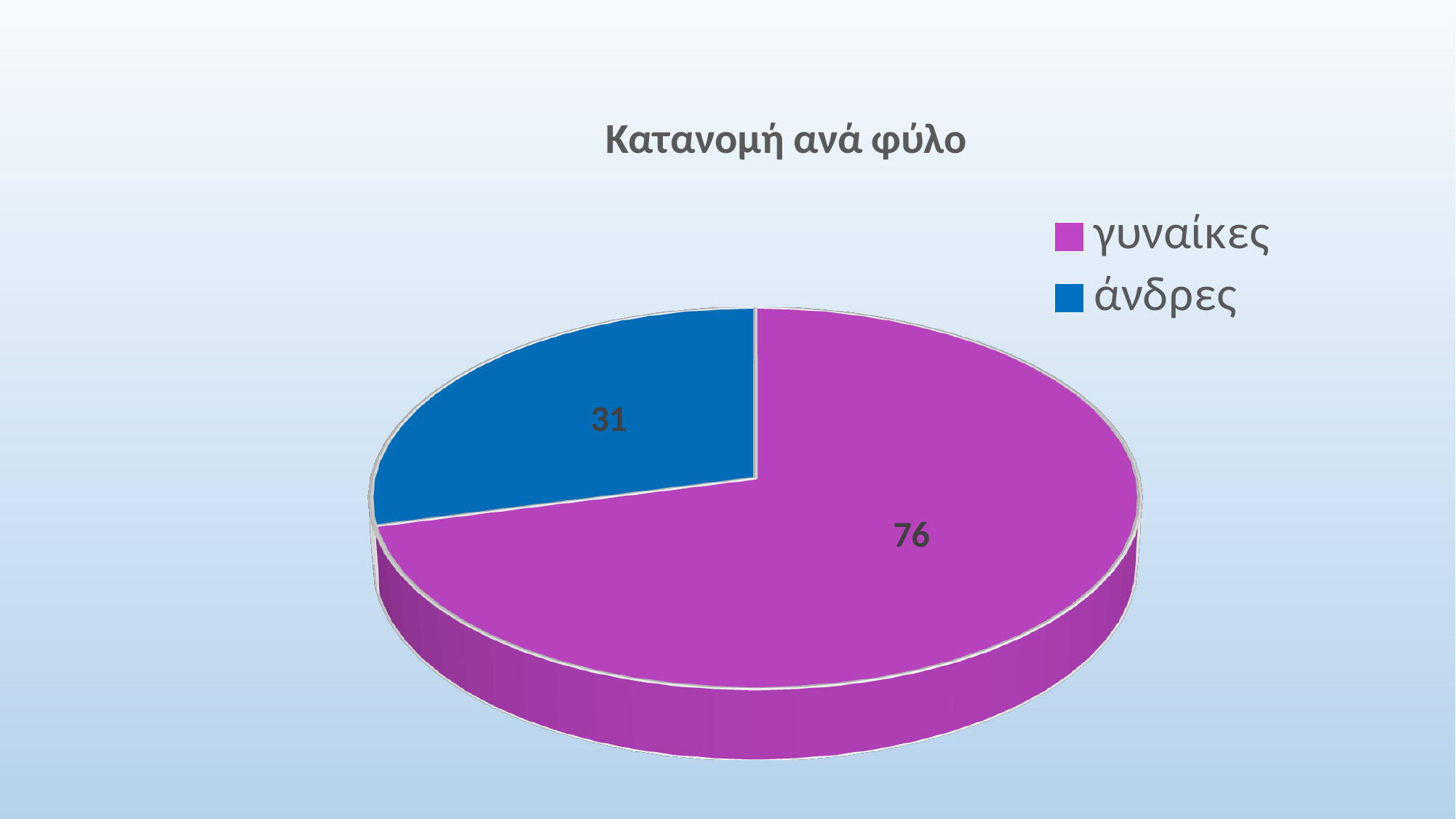
What is the value shown for γυναίκες? 76 What is the difference between the values for γυναίκες and άνδρες? 45 What kind of chart is shown on the slide? Pie chart How many categories does the pie chart show? 2 What is the value shown for άνδρες? 31 Which category has the largest slice of the pie? γυναίκες What colour is the slice for άνδρες? Blue Which category has the smallest slice of the pie? άνδρες What is the total of the two values shown in the pie chart? 107 Which is larger, the value for γυναίκες or the value for άνδρες? γυναίκες What is the title of the chart? Κατανομή ανά φύλο